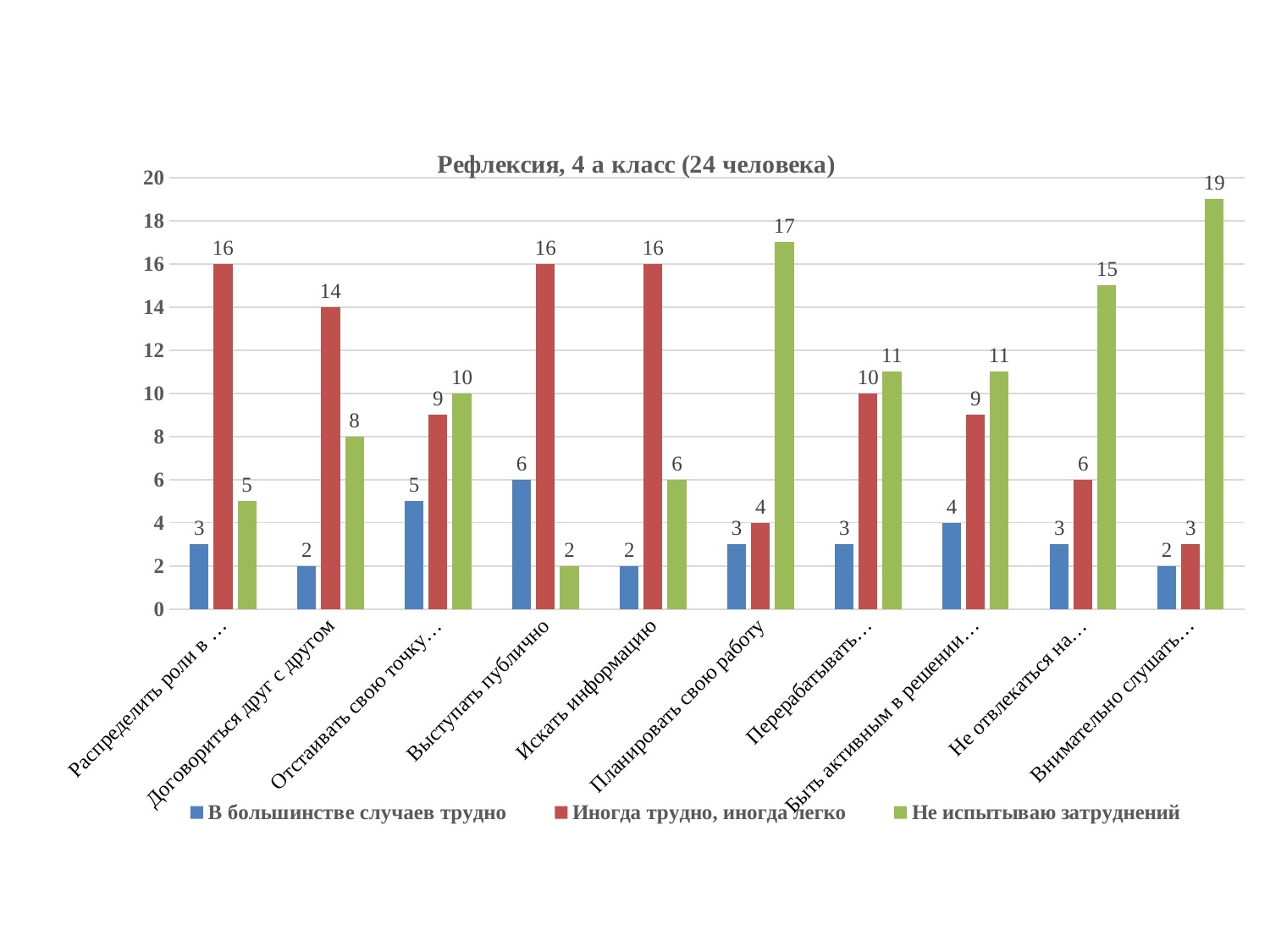
What is the value of "Иногда трудно, иногда легко" for "Договориться друг с другом"? 14 What is the difference between the "Иногда трудно, иногда легко" and "Не испытываю затруднений" values for "Выступать публично"? 14 For "Планировать свою работу", which is larger: "Иногда трудно, иногда легко" or "Не испытываю затруднений"? Не испытываю затруднений How many categories are shown on the x axis? 10 What kind of chart is shown on the slide? Bar chart What is the value of "Не испытываю затруднений" for "Планировать свою работу"? 17 What is the title of the chart? Рефлексия, 4 а класс (24 человека) Which category has the lowest value for "Не испытываю затруднений"? Выступать публично What is the value of "В большинстве случаев трудно" for "Выступать публично"? 6 What is the value of "Не испытываю затруднений" for "Искать информацию"? 6 Which category has the highest value for "В большинстве случаев трудно"? Выступать публично How many series does the legend list? 3